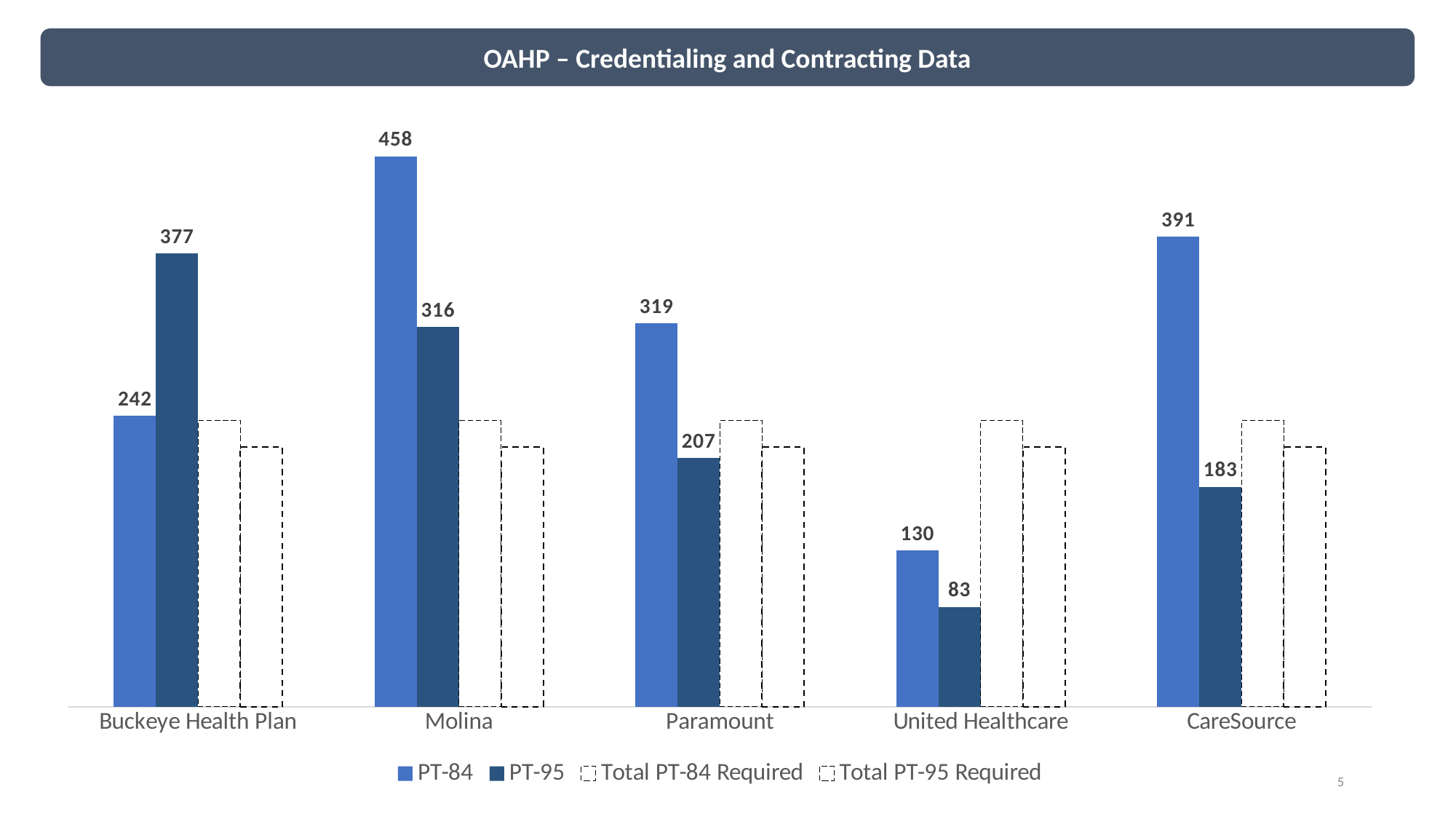
What kind of chart is shown on the slide? Bar chart What is the PT-84 value for CareSource? 391 What is the difference between the PT-84 and PT-95 values for Paramount? 112 What is the PT-95 value for Buckeye Health Plan? 377 What is the PT-95 value for United Healthcare? 83 How many series does the legend list? 4 What is the title of the slide? OAHP – Credentialing and Contracting Data What is the PT-84 value for Molina? 458 Which category has the lowest PT-95 value? United Healthcare How many categories are shown on the x axis? 5 Which category has the highest PT-84 value? Molina Which is larger for Buckeye Health Plan, the PT-84 value or the PT-95 value? PT-95